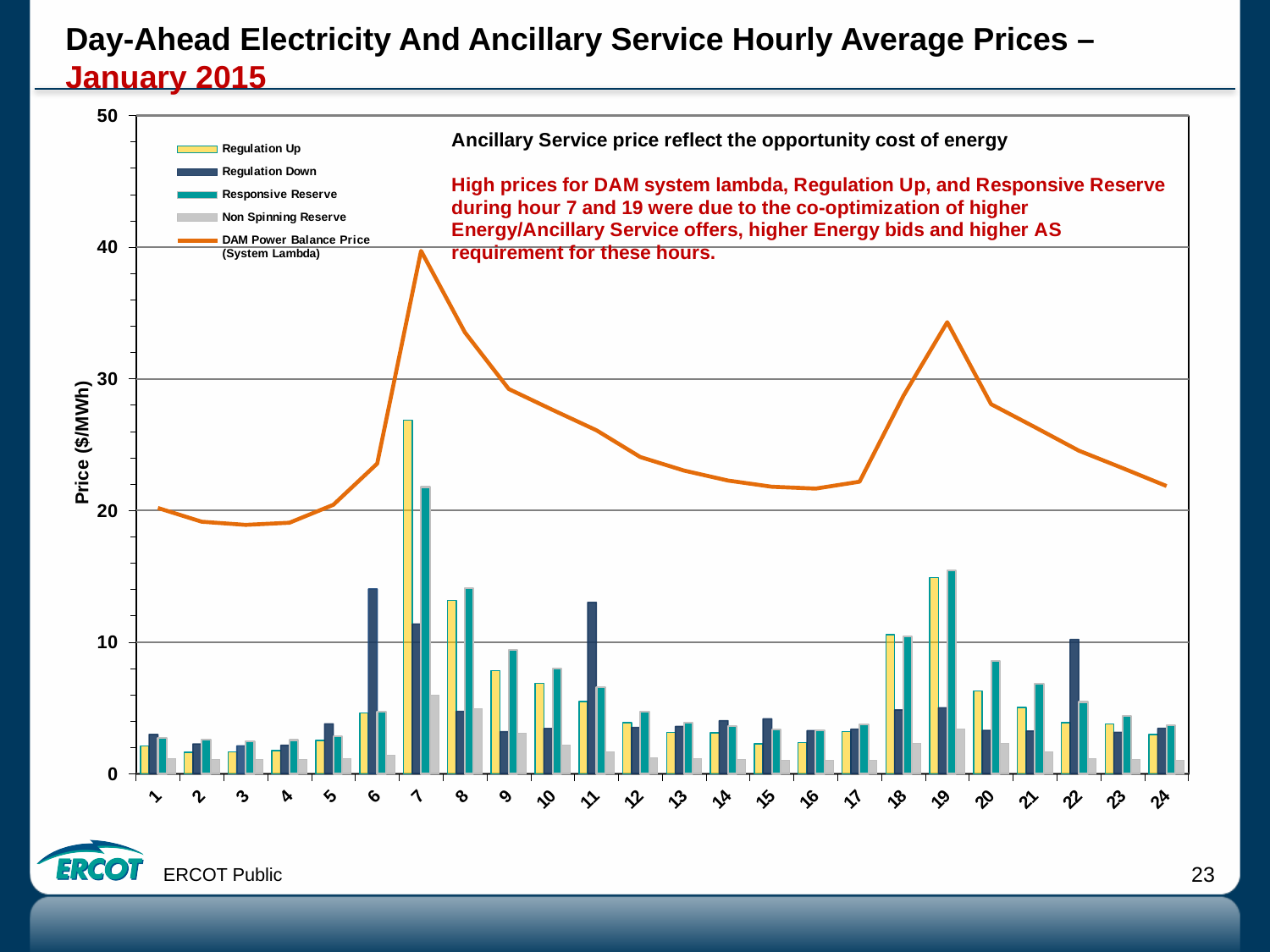
Does the DAM Power Balance Price (System Lambda) rise or fall from hour 19 to hour 24? Fall What is the label on the y axis? Price ($/MWh) At which hour is the Responsive Reserve price highest? 7 How many hours are shown along the x axis? 24 Which is larger, the DAM Power Balance Price (System Lambda) at hour 7 or at hour 19? Hour 7 How many series does the legend list? 5 At which hour is the DAM Power Balance Price (System Lambda) highest? 7 At which hour is the Regulation Up price highest? 7 Is the Regulation Up price at hour 7 greater or less than 20? greater Is the DAM Power Balance Price (System Lambda) at hour 19 greater or less than 30? greater What kind of chart is shown on the slide? A combination bar and line chart Is the Non Spinning Reserve price at hour 7 greater or less than 10? less